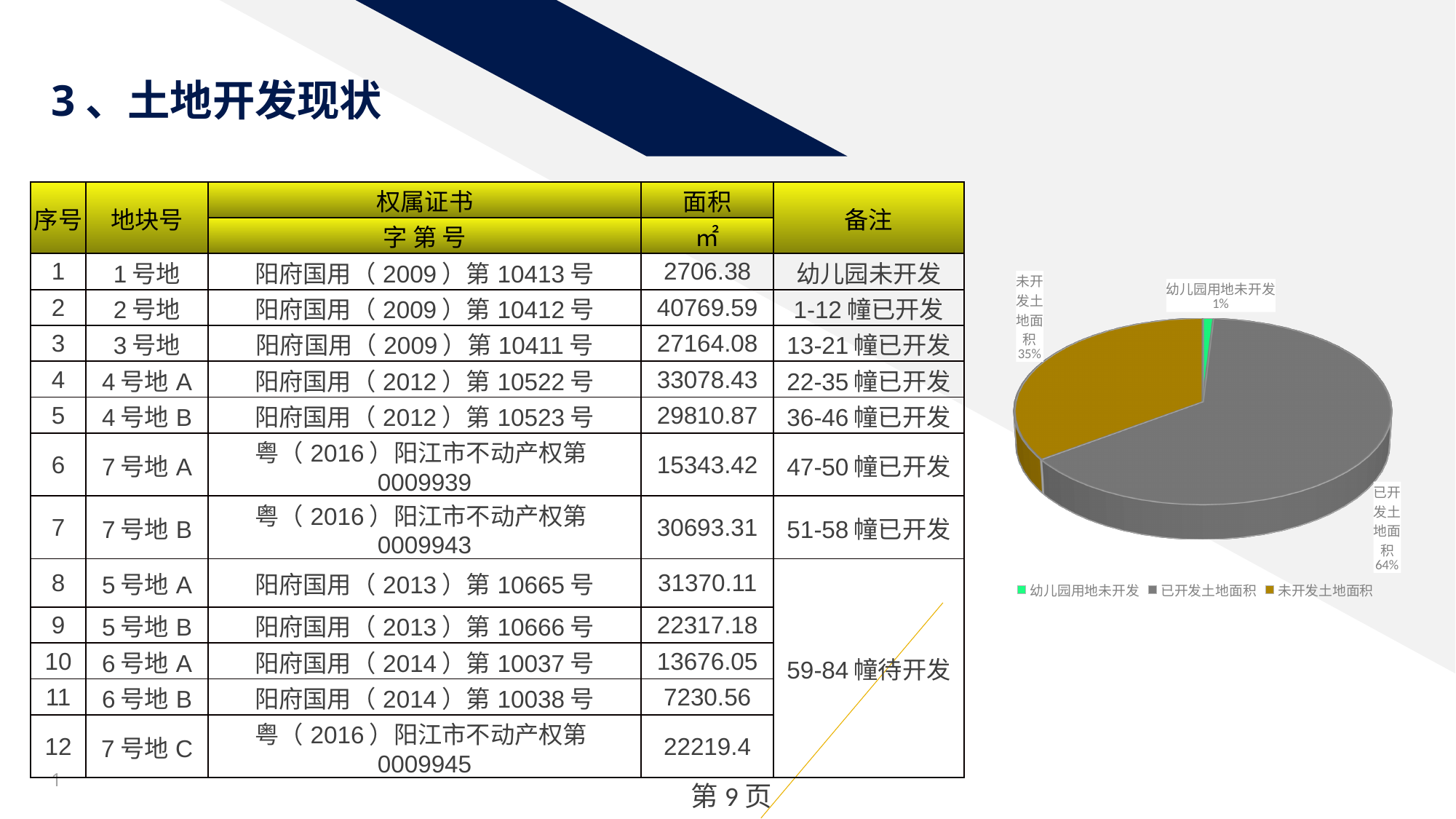
What share of the pie does 幼儿园用地未开发 represent? 1% In the pie chart, which is larger: 已开发土地面积 or 未开发土地面积? 已开发土地面积 What share of the pie does 未开发土地面积 represent? 35% What is the difference in percentage points between the 已开发土地面积 slice and the 未开发土地面积 slice? 29 What kind of chart is shown on the right side of the slide? pie chart What colour is the 幼儿园用地未开发 slice in the pie chart? green What share of the pie does 已开发土地面积 represent? 64% What colour is the 未开发土地面积 slice in the pie chart? gold How many entries does the pie chart's legend list? 3 Which slice of the pie chart is the largest? 已开发土地面积 How many slices does the pie chart have? 3 Which slice of the pie chart is the smallest? 幼儿园用地未开发